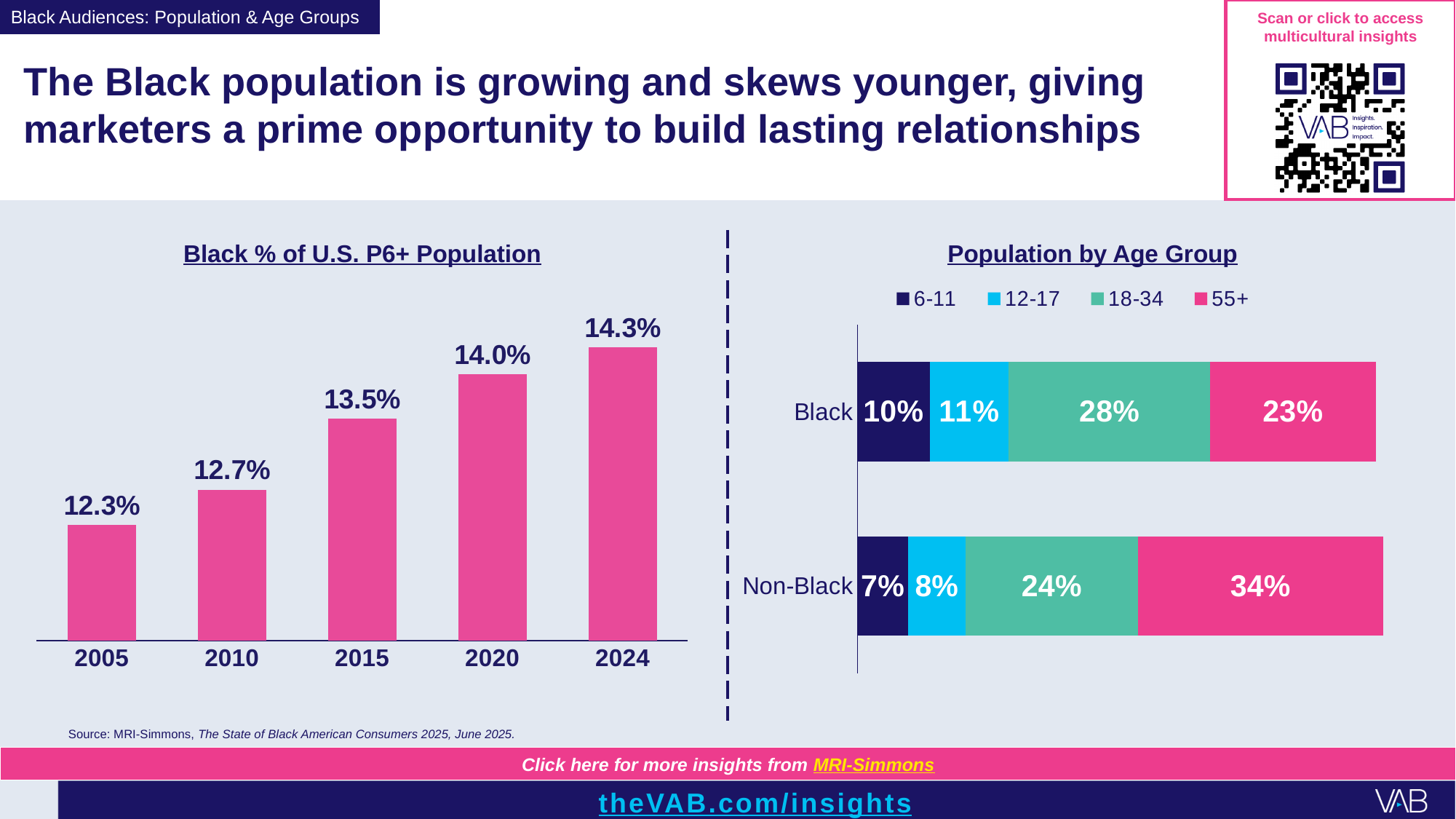
In the 'Black % of U.S. P6+ Population' chart, how many years are shown? 5 In the 'Black % of U.S. P6+ Population' chart, which year has the lowest value? 2005 In the 'Black % of U.S. P6+ Population' chart, what is the value for 2015? 13.5% What kind of chart is the 'Black % of U.S. P6+ Population' chart? bar chart In the 'Population by Age Group' chart, what is the total of the Black bar's labelled segments? 72% In the 'Black % of U.S. P6+ Population' chart, do the values rise or fall from 2005 to 2024? rise In the 'Population by Age Group' chart, how many series does the legend list? 4 In the 'Population by Age Group' chart, what is the 18-34 value for Black? 28% In the 'Population by Age Group' chart, what is the 55+ value for Non-Black? 34% In the 'Black % of U.S. P6+ Population' chart, which year has the highest value? 2024 In the 'Black % of U.S. P6+ Population' chart, what is the difference between the 2024 and 2005 values? 2.0% In the 'Population by Age Group' chart, which is larger: the 55+ value for Black or for Non-Black? Non-Black